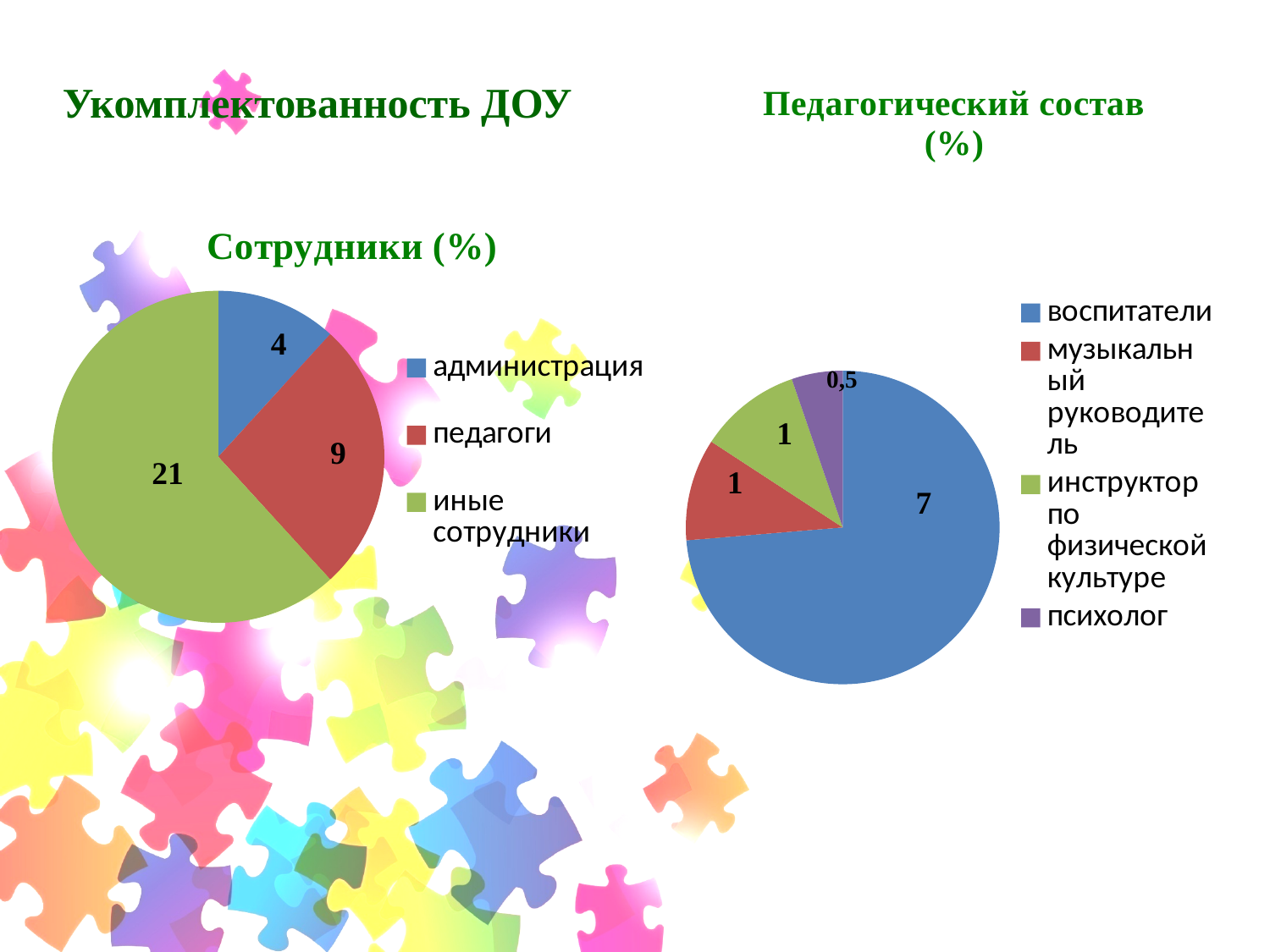
In the 'Педагогический состав (%)' chart, which category has the smallest slice? психолог In the 'Сотрудники (%)' chart, what is the value for педагоги? 9 In the 'Педагогический состав (%)' chart, which is larger: воспитатели or инструктор по физической культуре? воспитатели In the 'Сотрудники (%)' chart, what is the value for администрация? 4 In the 'Сотрудники (%)' chart, which category has the smallest slice? администрация In the 'Педагогический состав (%)' chart, how many entries does the legend list? 4 In the 'Сотрудники (%)' chart, what is the difference between иные сотрудники and администрация? 17 In the 'Педагогический состав (%)' chart, what is the value for воспитатели? 7 What type of chart is the 'Сотрудники (%)' chart? pie chart In the 'Сотрудники (%)' chart, which category has the largest slice? иные сотрудники In the 'Педагогический состав (%)' chart, what is the value for психолог? 0,5 In the 'Сотрудники (%)' chart, how many categories are shown? 3